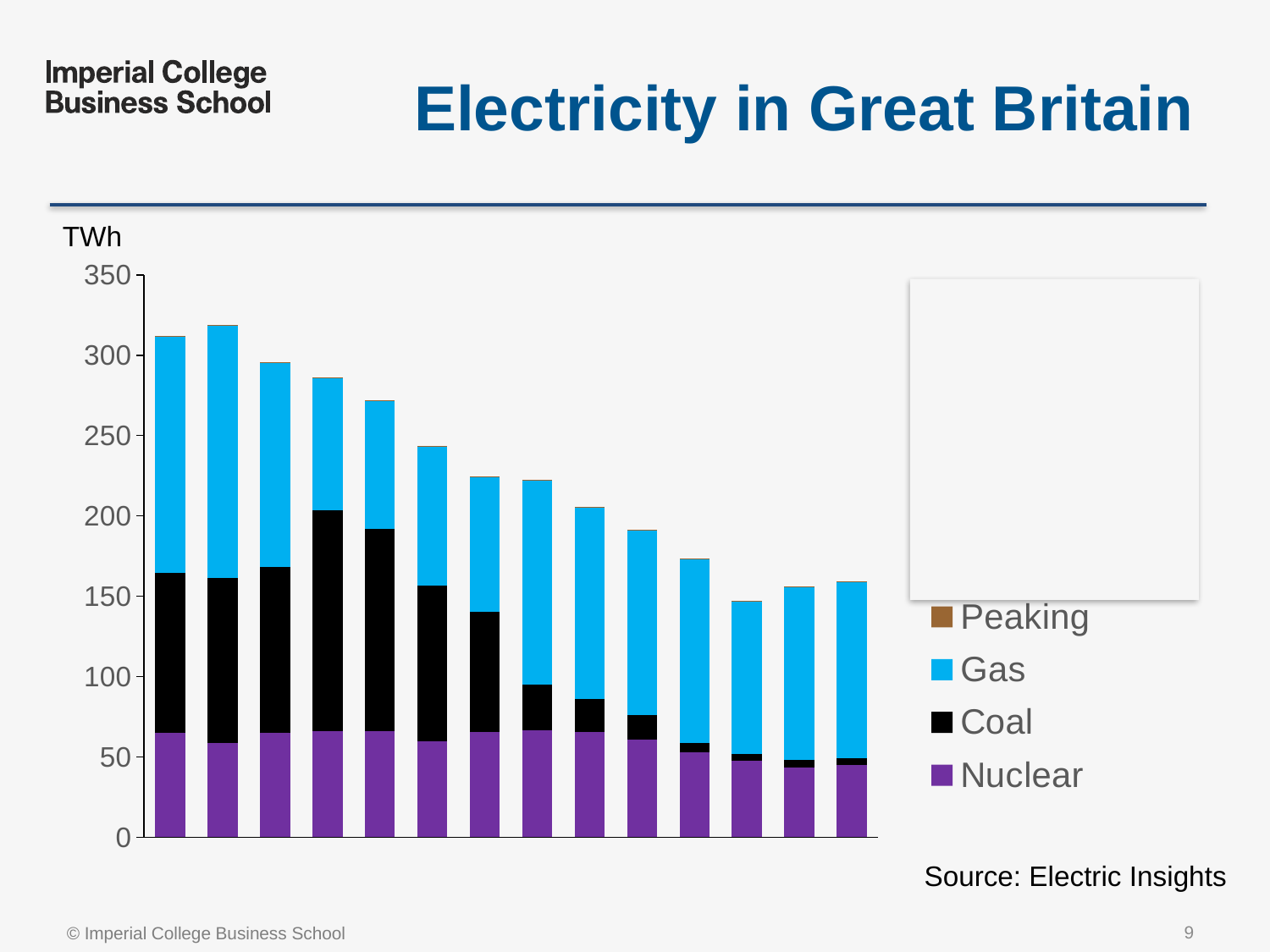
Do the total bar heights generally rise or fall from left to right? Fall Which is larger, the total of the leftmost bar or the total of the rightmost bar? The leftmost bar Is the total of the leftmost bar greater or less than 300? greater What unit is shown on the y axis? TWh Which bar has the lowest total? The third bar from the right Which bar has the highest total? The second bar from the left Is the Nuclear segment of the leftmost bar greater or less than 50? greater Is the total of the rightmost bar greater or less than 200? less How many bars are plotted in the chart? 14 How many series does the legend list? 4 Which series is plotted at the bottom of each stacked bar? Nuclear What kind of chart is shown on the slide? Stacked bar chart